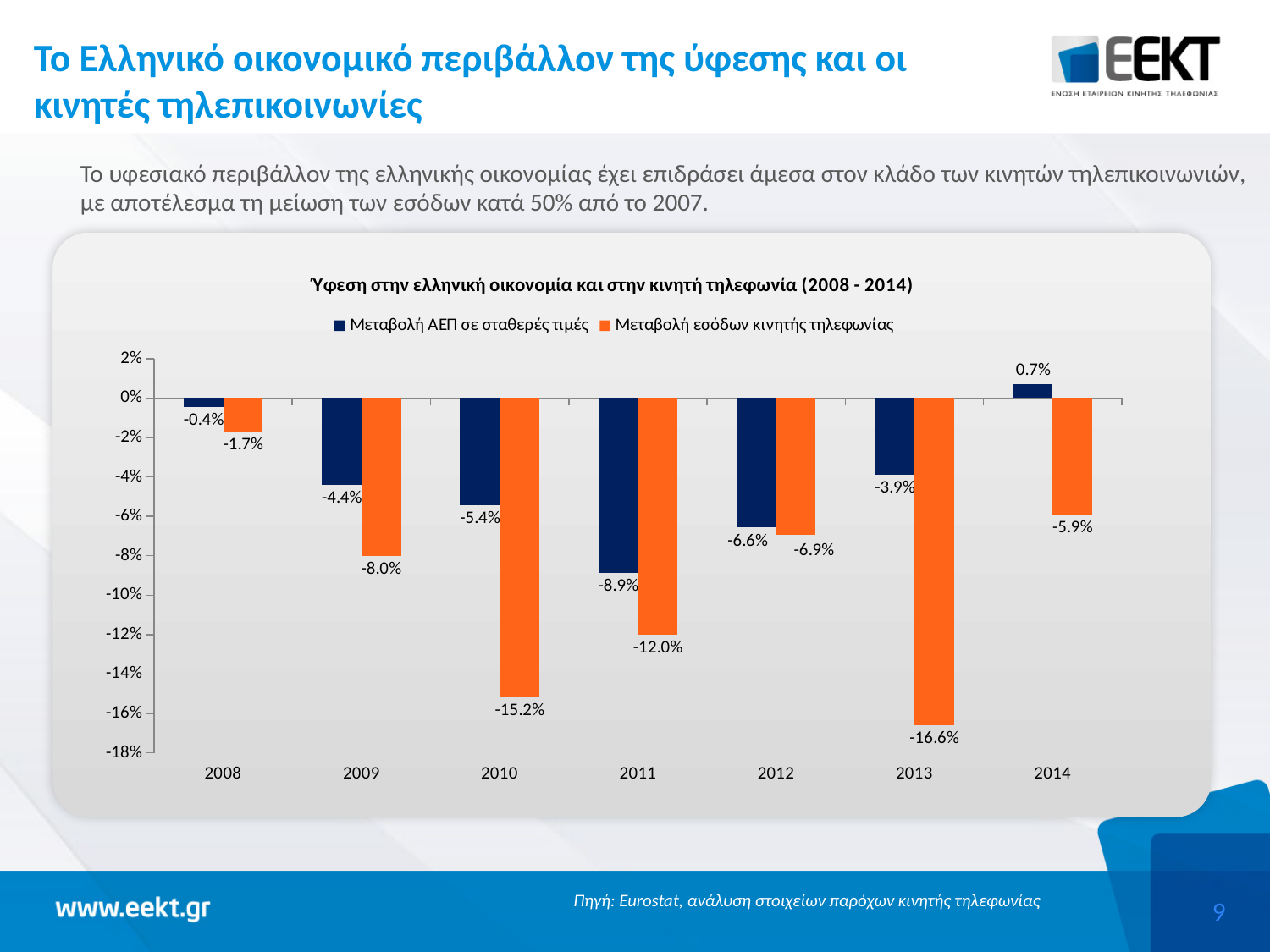
In which year is Μεταβολή ΑΕΠ σε σταθερές τιμές lowest? 2011 What kind of chart is shown on the slide? Bar chart What is the value of Μεταβολή ΑΕΠ σε σταθερές τιμές for 2014? 0.7% How many years are shown on the x axis of the chart? 7 Which is larger in 2012: Μεταβολή ΑΕΠ σε σταθερές τιμές or Μεταβολή εσόδων κινητής τηλεφωνίας? Μεταβολή ΑΕΠ σε σταθερές τιμές What is the value of Μεταβολή εσόδων κινητής τηλεφωνίας for 2013? -16.6% What is the difference between Μεταβολή εσόδων κινητής τηλεφωνίας and Μεταβολή ΑΕΠ σε σταθερές τιμές in 2013? 12.7 percentage points What is the value of Μεταβολή εσόδων κινητής τηλεφωνίας for 2010? -15.2% What is the value of Μεταβολή ΑΕΠ σε σταθερές τιμές for 2011? -8.9% In which year is Μεταβολή εσόδων κινητής τηλεφωνίας lowest? 2013 How many series does the chart legend list? 2 In which year is Μεταβολή ΑΕΠ σε σταθερές τιμές highest? 2014